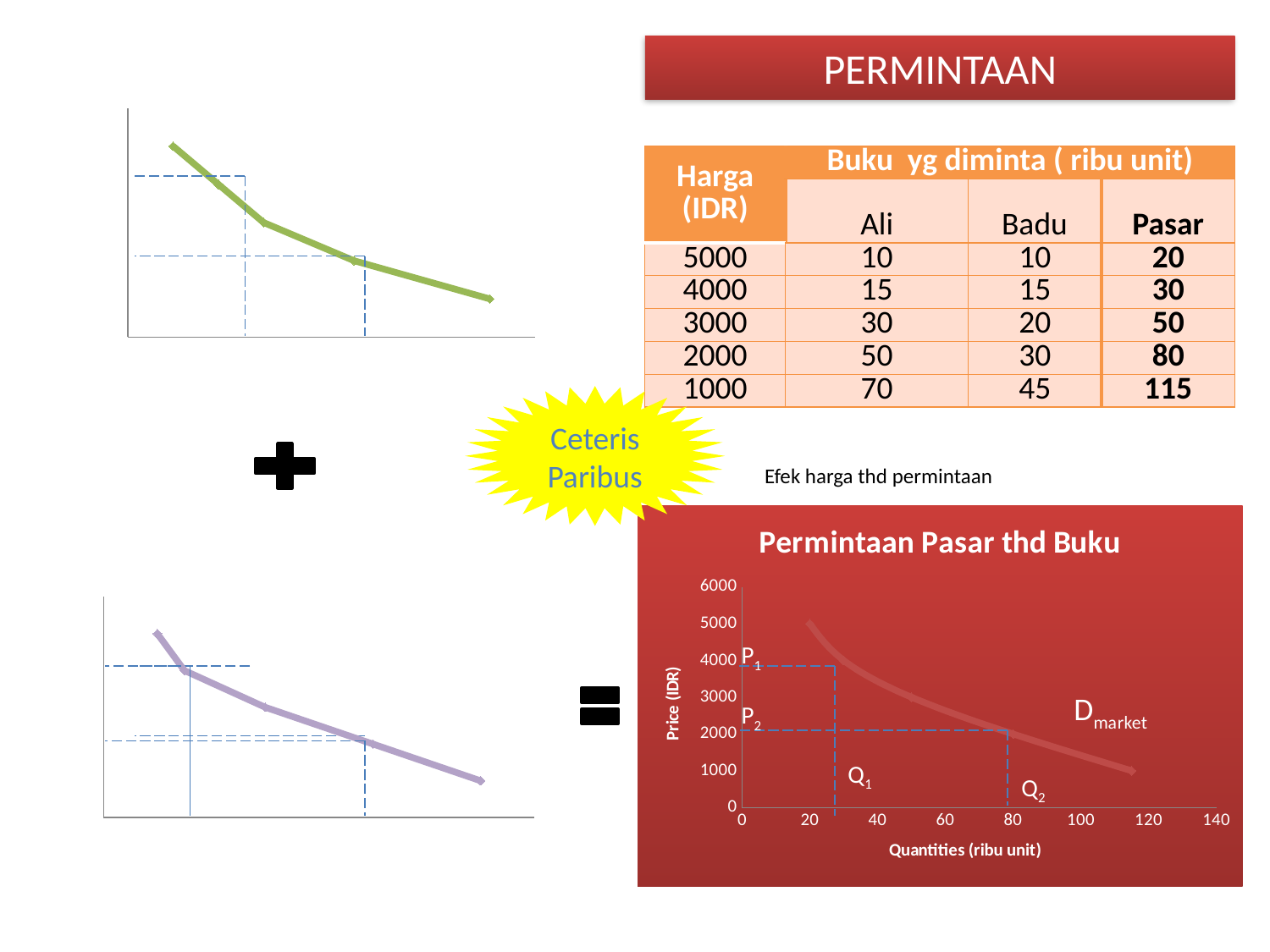
What is the title of the chart in the lower right of the slide? Permintaan Pasar thd Buku In the 'Permintaan Pasar thd Buku' chart, is the quantity at a price of 3000 greater or less than 40? greater In the 'Permintaan Pasar thd Buku' chart, is the quantity at a price of 1000 greater or less than 100? greater In the 'Permintaan Pasar thd Buku' chart, what label is written next to the demand curve? Dmarket In the 'Permintaan Pasar thd Buku' chart, what quantity does the curve reach at a price of 2000 (marked Q2)? 80 How many charts are shown on the slide? 3 In the 'Permintaan Pasar thd Buku' chart, what quantity does the curve reach at a price of 5000? 20 What kind of chart is 'Permintaan Pasar thd Buku'? line chart In the 'Permintaan Pasar thd Buku' chart, is the quantity at a price of 4000 greater or less than 40? less In the 'Permintaan Pasar thd Buku' chart, which is larger: the quantity at price 5000 or the quantity at price 1000? quantity at price 1000 In the 'Permintaan Pasar thd Buku' chart, does the price rise or fall as quantity increases along the x axis? fall What kind of chart is the small chart in the upper left of the slide? line chart